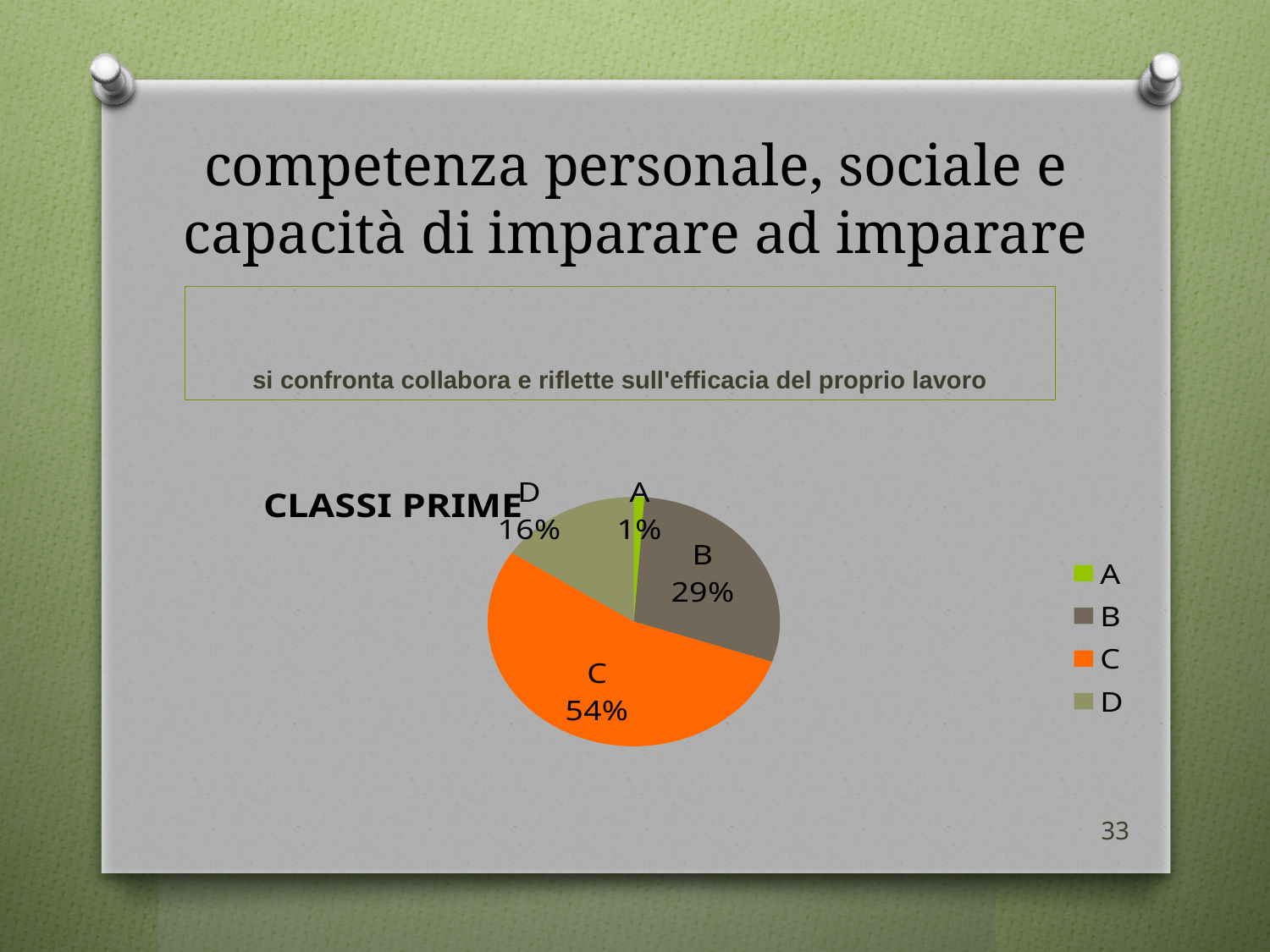
What percentage does slice D represent? 16% How many categories does the legend list? 4 Which is larger, the share for B or the share for D? B What is the difference in percentage points between slice C and slice B? 25 What colour is the slice for category C? orange What kind of chart is shown on the slide? pie chart What percentage does slice C represent? 54% Which category has the smallest share of the pie? A What percentage does slice B represent? 29% Which category has the largest share of the pie? C What is the title of the chart? CLASSI PRIME What percentage does slice A represent? 1%